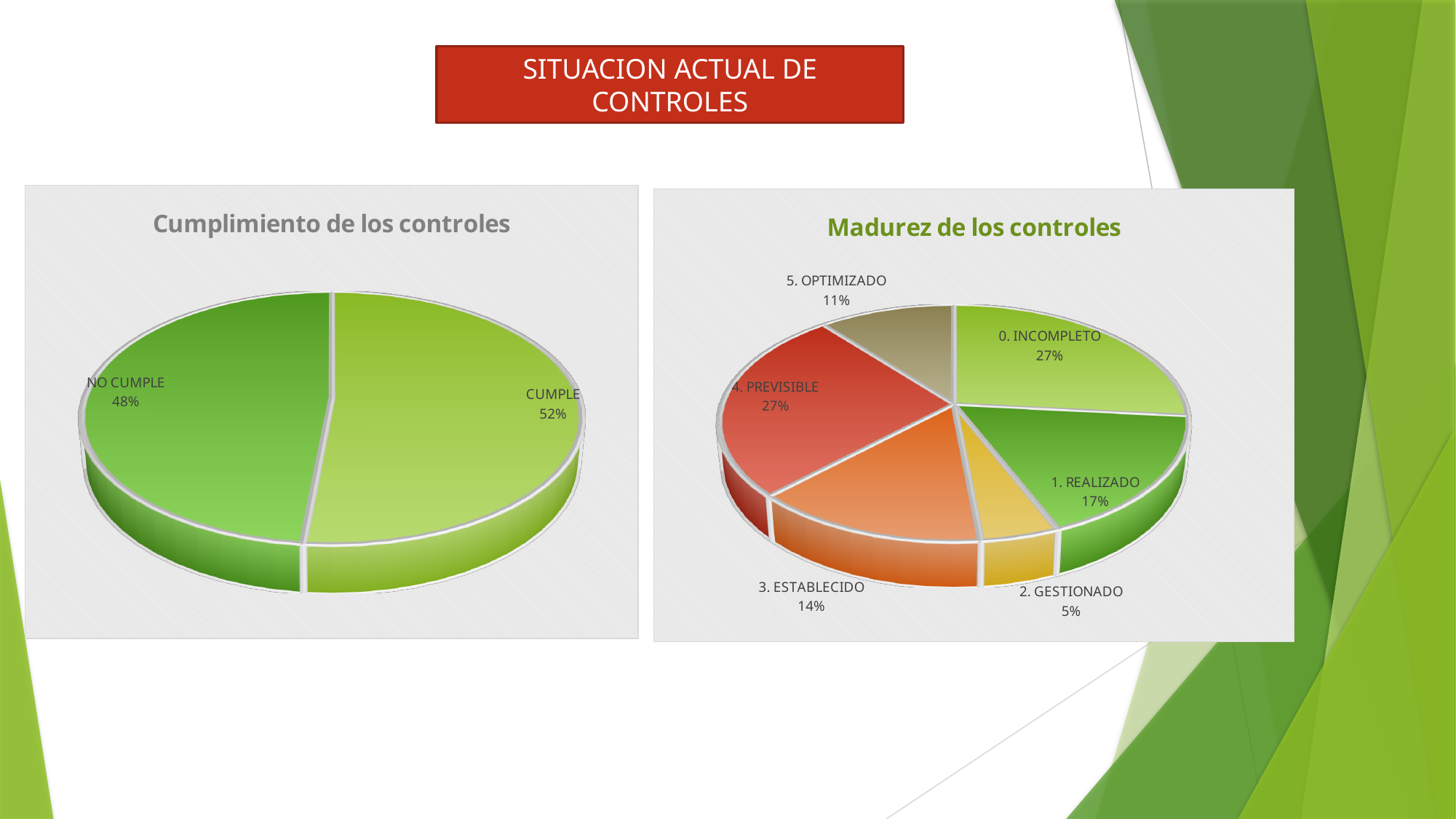
In the 'Madurez de los controles' chart, which category has the smallest share? 2. GESTIONADO In the 'Madurez de los controles' chart, what is the difference in percentage points between 3. ESTABLECIDO and 2. GESTIONADO? 9 percentage points In the 'Cumplimiento de los controles' chart, what is the share for NO CUMPLE? 48% In the 'Madurez de los controles' chart, what is the share for 2. GESTIONADO? 5% In the 'Madurez de los controles' chart, which is larger, 1. REALIZADO or 3. ESTABLECIDO? 1. REALIZADO In the 'Madurez de los controles' chart, what is the share for 5. OPTIMIZADO? 11% In the 'Madurez de los controles' chart, what is the share for 1. REALIZADO? 17% In the 'Cumplimiento de los controles' chart, what is the difference in percentage points between CUMPLE and NO CUMPLE? 4 percentage points In the 'Madurez de los controles' chart, how many categories are shown? 6 In the 'Cumplimiento de los controles' chart, what is the share for CUMPLE? 52% In the 'Cumplimiento de los controles' chart, which slice is larger, CUMPLE or NO CUMPLE? CUMPLE What kind of chart is 'Cumplimiento de los controles'? Pie chart